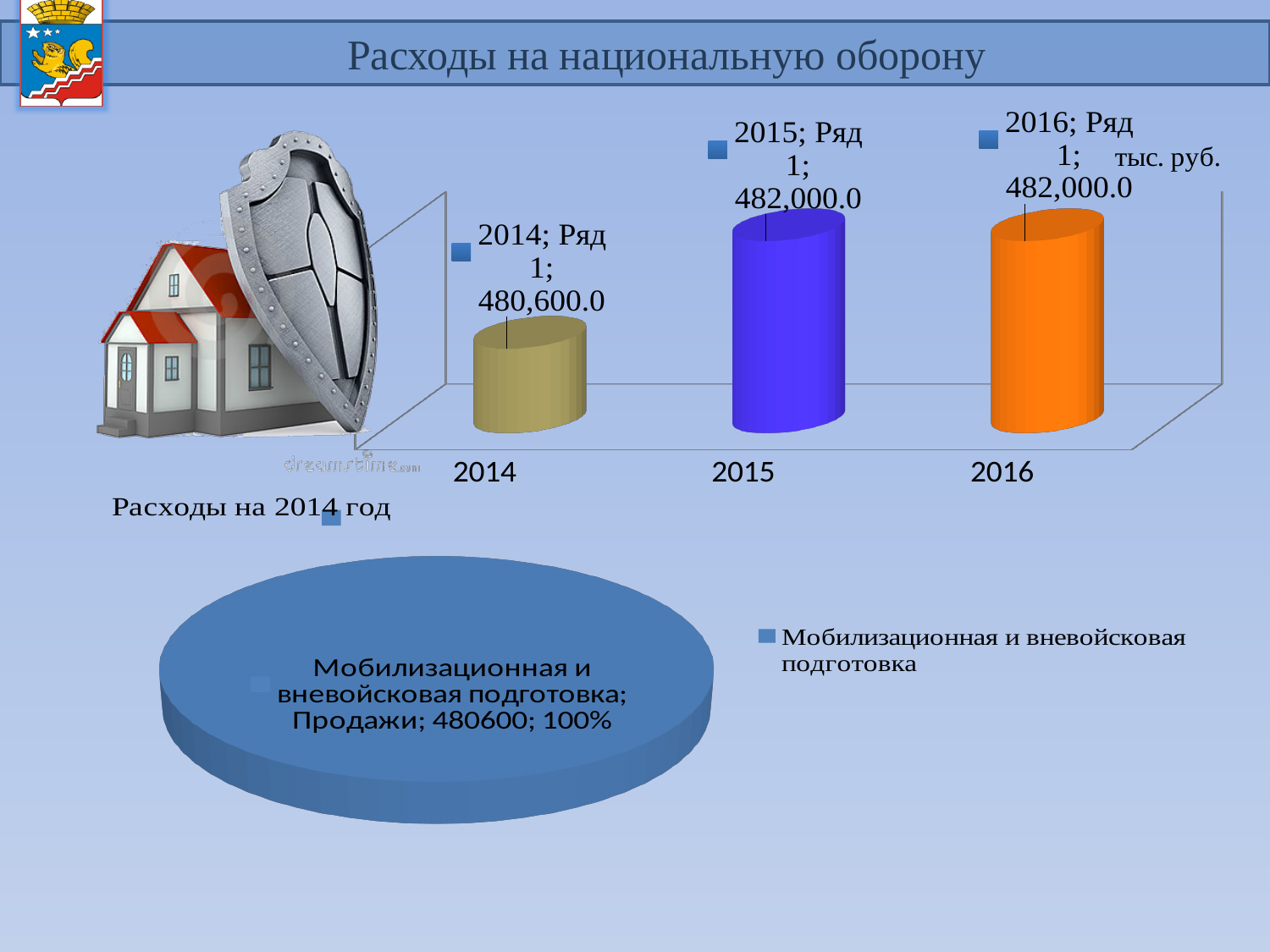
In the bar chart at the top of the slide, which year has the lowest value? 2014 In the bar chart at the top of the slide, what is the value for 2016? 482,000.0 In the bar chart at the top of the slide, what is the value for 2015? 482,000.0 How many years are shown in the bar chart at the top of the slide? 3 In the bar chart at the top of the slide, which is larger, the value for 2014 or the value for 2015? 2015 In the bar chart at the top of the slide, what is the difference between the values for 2015 and 2014? 1,400.0 What type of chart is the chart at the top of the slide showing values by year? Bar chart In the bar chart at the top of the slide, what unit is indicated next to the chart? тыс. руб. In the pie chart 'Расходы на 2014 год', what value is shown for 'Мобилизационная и вневойсковая подготовка'? 480600 In the pie chart 'Расходы на 2014 год', what share does 'Мобилизационная и вневойсковая подготовка' have? 100% What type of chart is the chart at the bottom of the slide titled 'Расходы на 2014 год'? Pie chart In the bar chart at the top of the slide, what is the value for 2014? 480,600.0